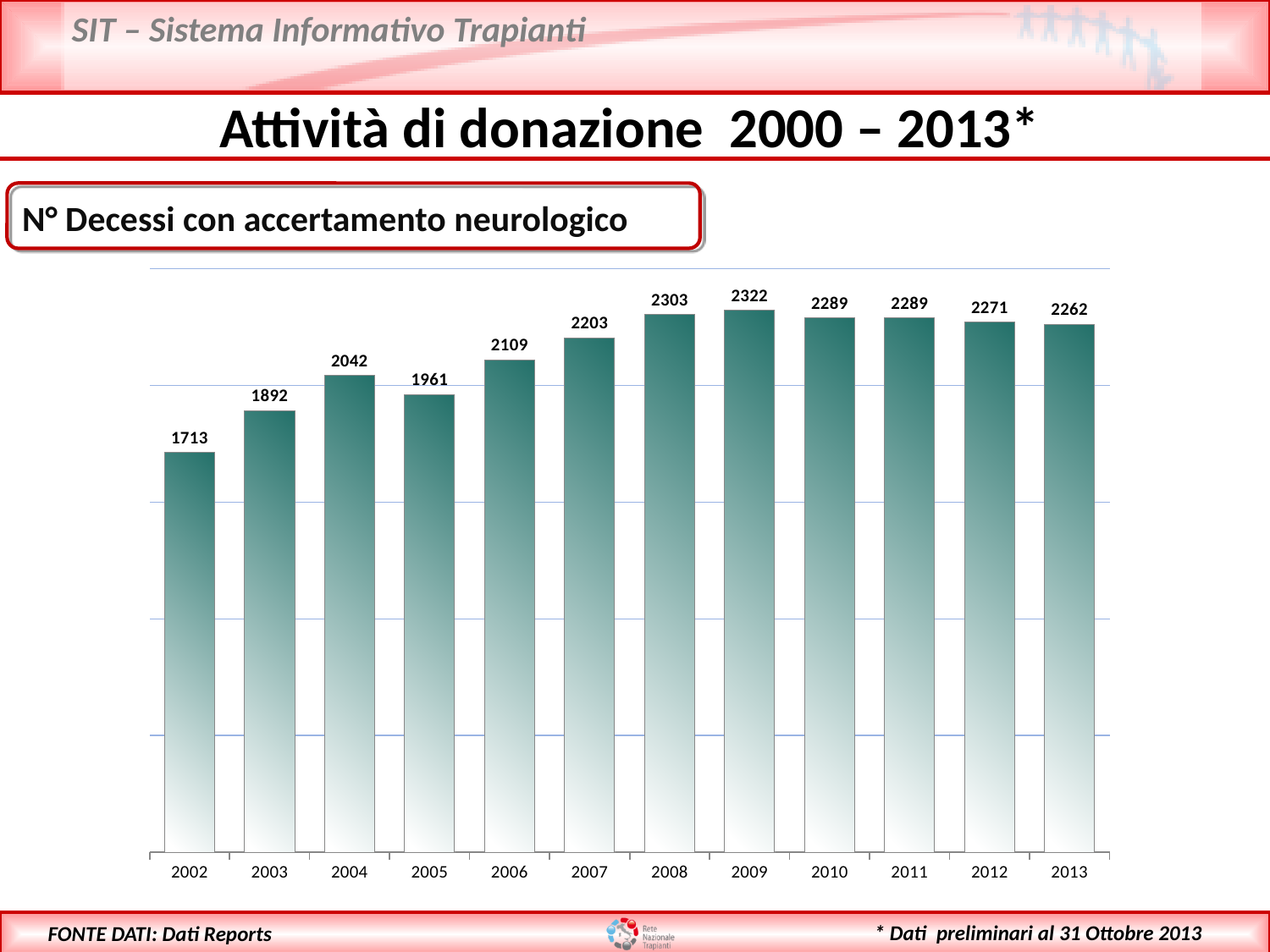
Do the values rise or fall from 2002 to 2004? Rise What is the value for 2013? 2262 Which year has the lowest value? 2002 How many years are shown on the x axis? 12 What kind of chart is shown on the slide? Bar chart Which is larger, the value for 2004 or the value for 2005? 2004 What is the value for 2009? 2322 What is the difference between the values for 2004 and 2005? 81 What is the value for 2002? 1713 What is the difference between the values for 2009 and 2002? 609 Which year has the highest value? 2009 What is the title of the chart? N° Decessi con accertamento neurologico